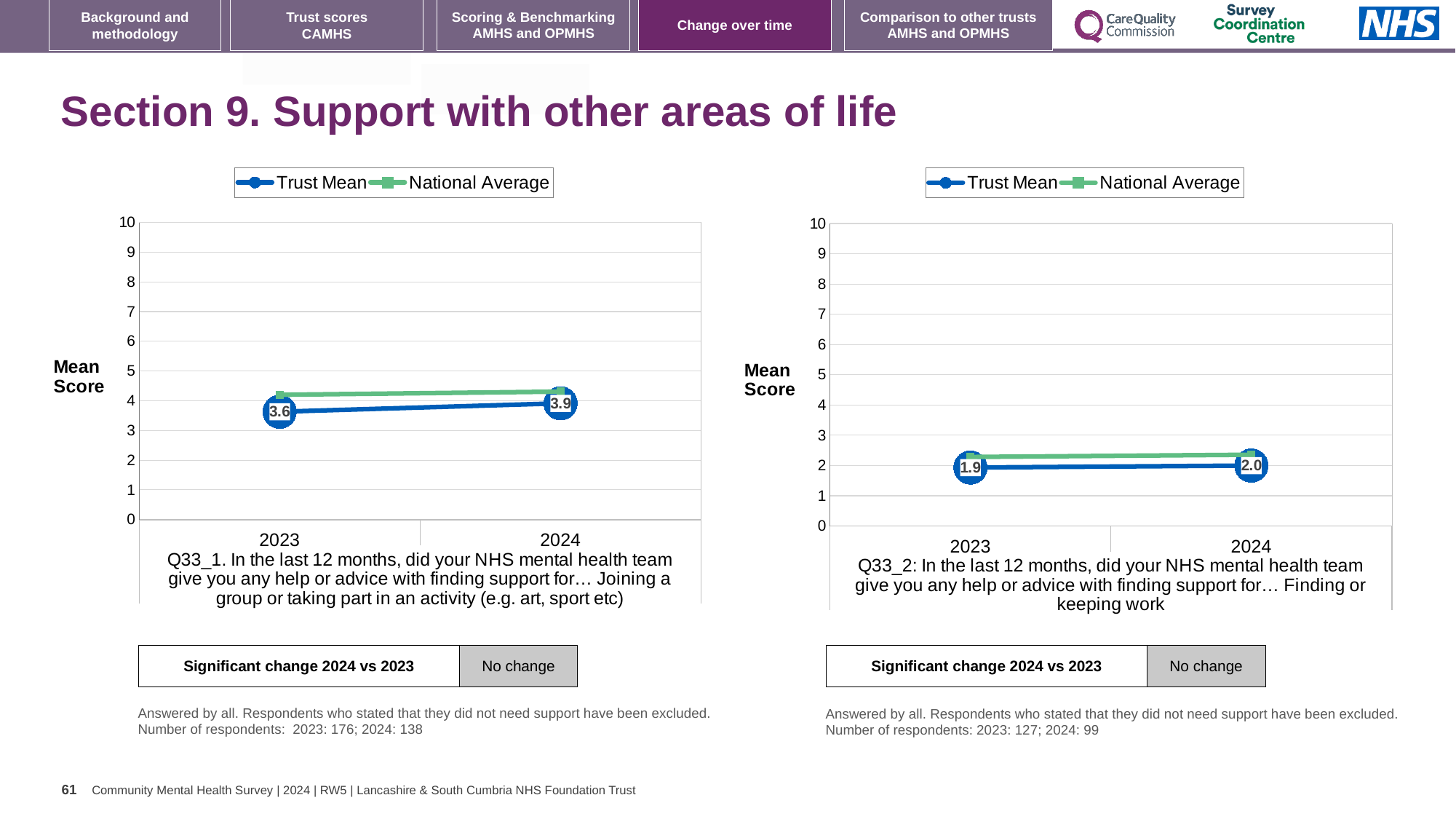
In the left chart (Q33_1), does the Trust Mean rise or fall from 2023 to 2024? rise In the left chart (Q33_1), what is the Trust Mean for 2023? 3.6 In the right chart (Q33_2), what is the difference between the Trust Mean in 2024 and 2023? 0.1 How many years are plotted on the x axis of the left chart (Q33_1)? 2 In the right chart (Q33_2), is the National Average for 2023 greater or less than 3? less In the right chart (Q33_2), what is the Trust Mean for 2023? 1.9 In the left chart (Q33_1), what is the Trust Mean for 2024? 3.9 How many series does the legend of the right chart (Q33_2) list? 2 In the left chart (Q33_1), for 2023, which is higher: the Trust Mean or the National Average? National Average In the left chart (Q33_1), by how much did the Trust Mean change from 2023 to 2024? 0.3 In the right chart (Q33_2), what is the Trust Mean for 2024? 2.0 What type of chart is used on the left of the slide? line chart